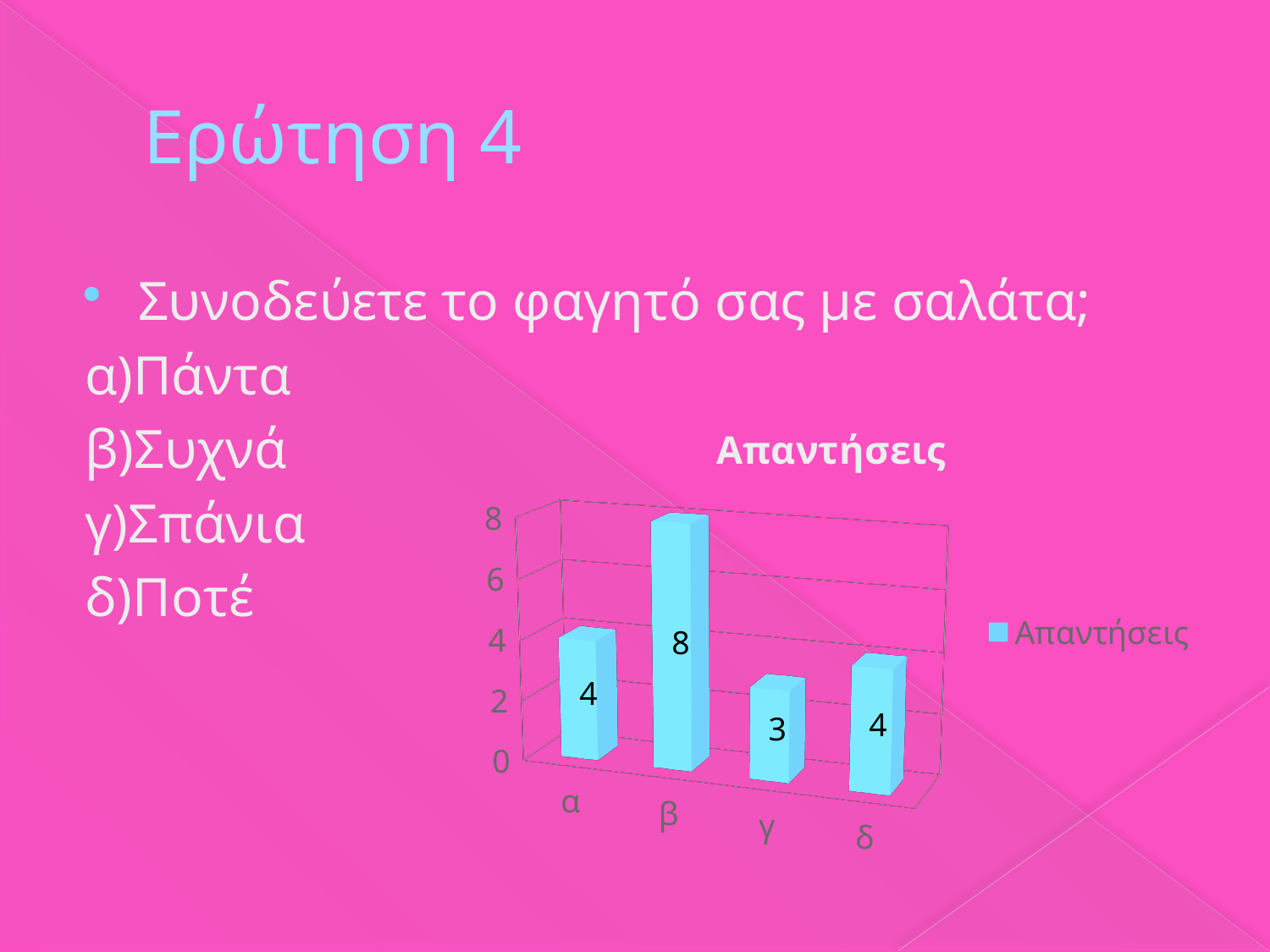
Which category has the lowest value? γ Which category has the highest value? β How many categories are shown on the x axis? 4 What is the value for category γ? 3 Is the value for β greater or less than 6? greater What kind of chart is shown on the slide? bar chart Which is larger, the value for β or the value for α? β What is the value for category β? 8 What is the title of the chart? Απαντήσεις What is the difference between the values for β and δ? 4 What is the value for category α? 4 What is the difference between the values for β and γ? 5